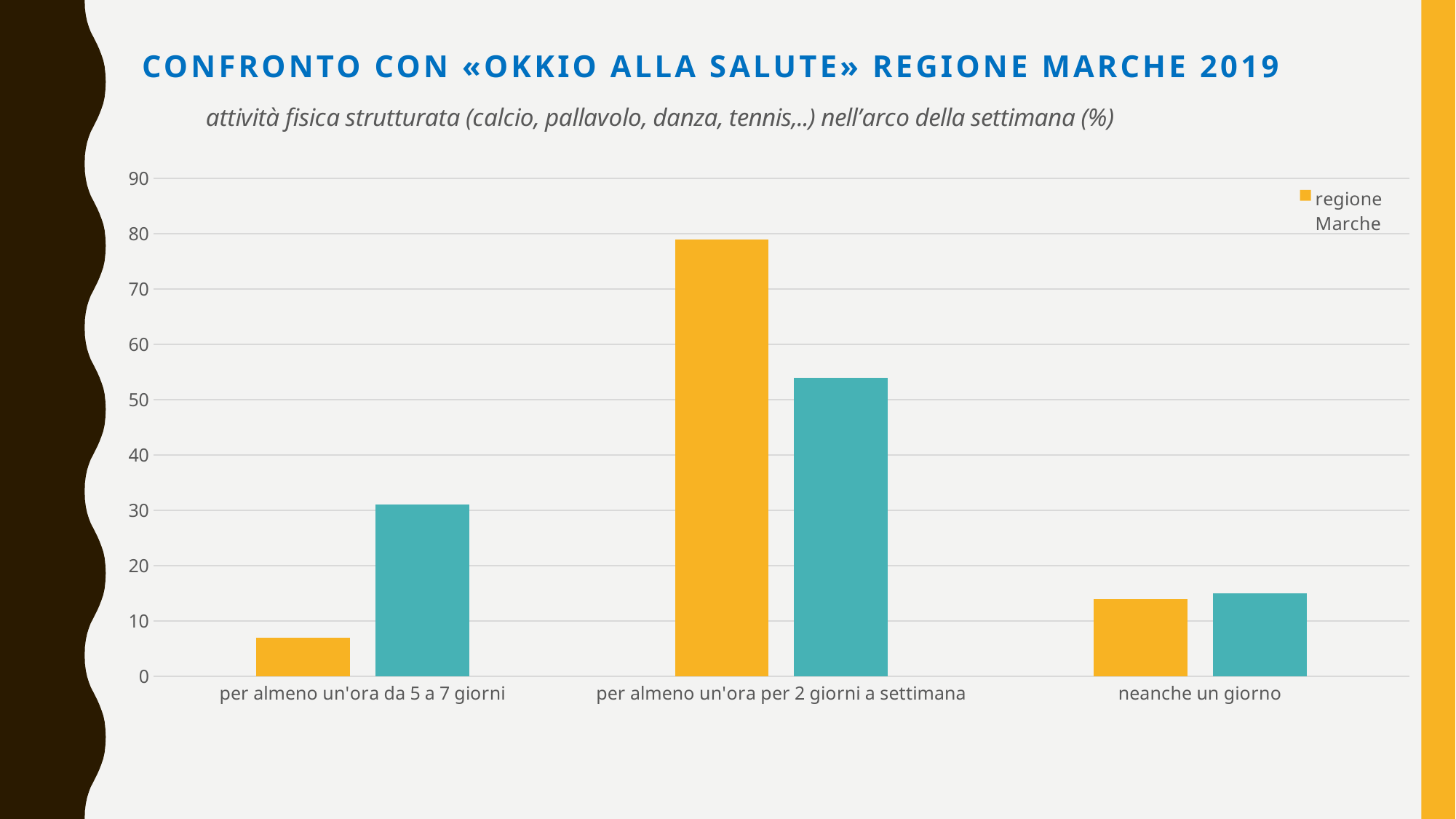
Is the regione Marche value for 'per almeno un'ora da 5 a 7 giorni' greater or less than 10? less In the category 'per almeno un'ora da 5 a 7 giorni', which bar is taller, the yellow regione Marche bar or the teal bar? the teal bar Is the teal bar for 'per almeno un'ora da 5 a 7 giorni' greater or less than 40? less Which category has the highest value for the regione Marche series? per almeno un'ora per 2 giorni a settimana What is the series name shown in the chart legend? regione Marche How many categories are shown on the x axis? 3 Which category has the lowest value for the regione Marche series? per almeno un'ora da 5 a 7 giorni Is the regione Marche value for 'neanche un giorno' greater or less than 10? greater What kind of chart is shown on the slide? bar chart In the category 'per almeno un'ora per 2 giorni a settimana', which bar is taller, the yellow regione Marche bar or the teal bar? the yellow regione Marche bar How many series does the legend list? 1